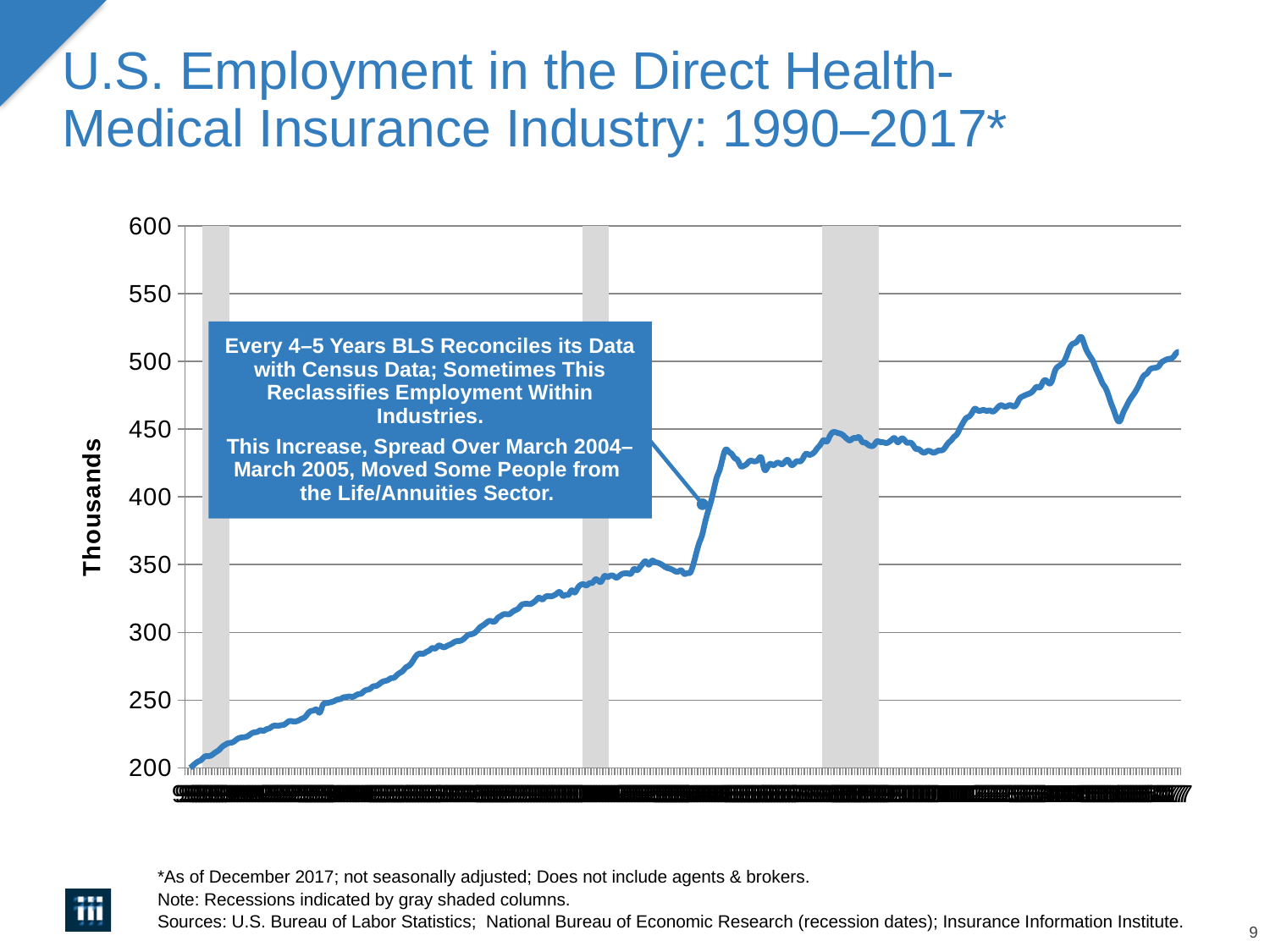
What is the title of the chart on the slide? U.S. Employment in the Direct Health-Medical Insurance Industry: 1990–2017* Is the value just before the sharp jump noted in the annotation (early 2004) greater or less than 400? less Is the highest point reached by the line greater or less than 500? greater Is the value at the end of the series (December 2017) greater or less than 450? greater What is the label on the vertical axis of the chart? Thousands What kind of chart is shown on the slide? line chart Overall, do the values rise or fall from the start of the series to the end? rise How many gray shaded recession columns appear on the chart? 3 What is the highest value shown on the vertical axis? 600